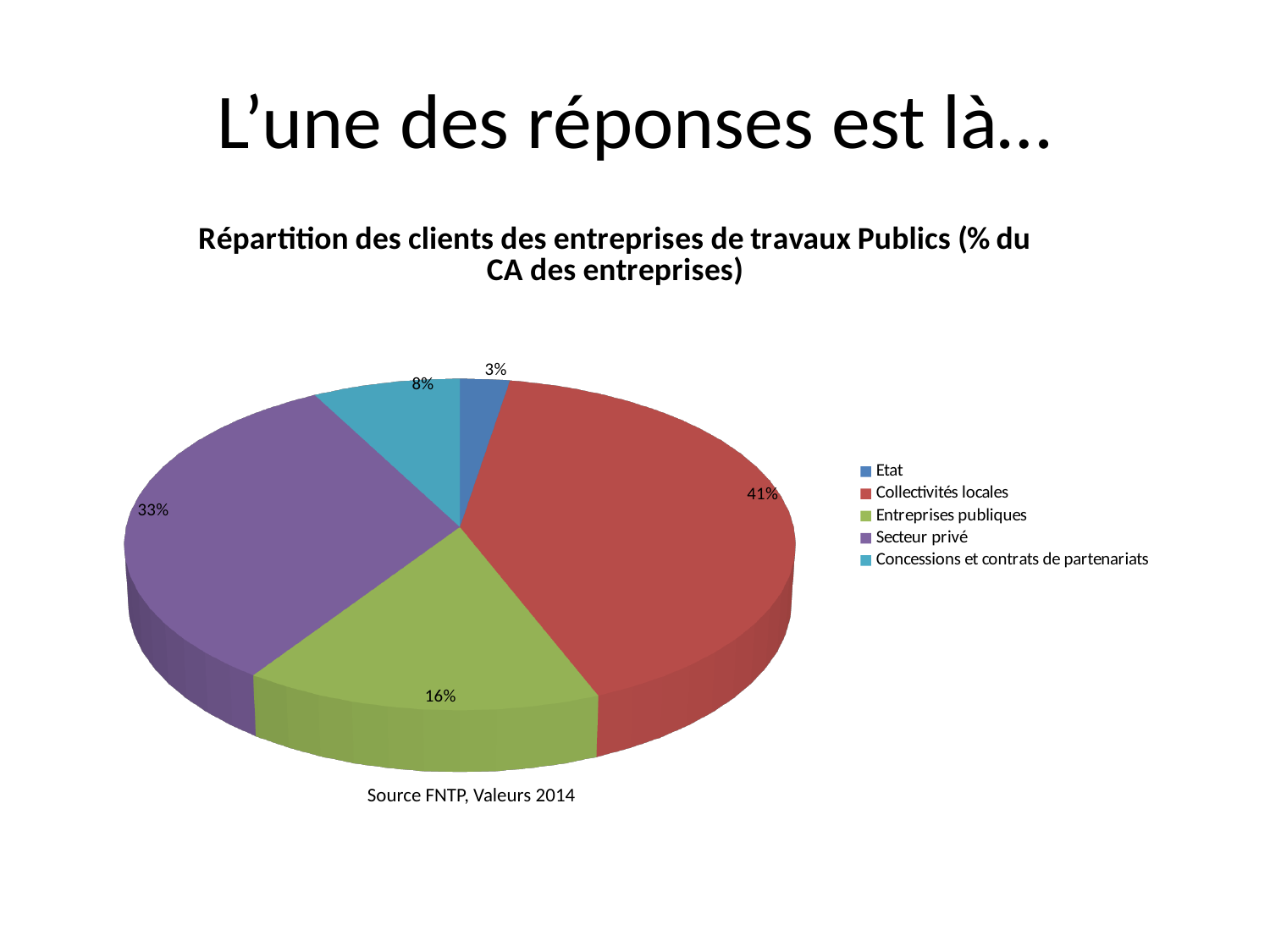
How many categories does the pie chart have? 5 Which category has the smallest slice of the pie? Etat What share of the pie does Collectivités locales represent? 41% What is the difference between the shares of Collectivités locales and Secteur privé? 8% Which is larger, the share for Entreprises publiques or the share for Concessions et contrats de partenariats? Entreprises publiques What kind of chart is shown on the slide? Pie chart Which category has the largest slice of the pie? Collectivités locales What is the value shown for Etat? 3% What is the value shown for Concessions et contrats de partenariats? 8% What source is cited below the chart? Source FNTP, Valeurs 2014 What is the value shown for Entreprises publiques? 16% What share of the pie does Secteur privé represent? 33%